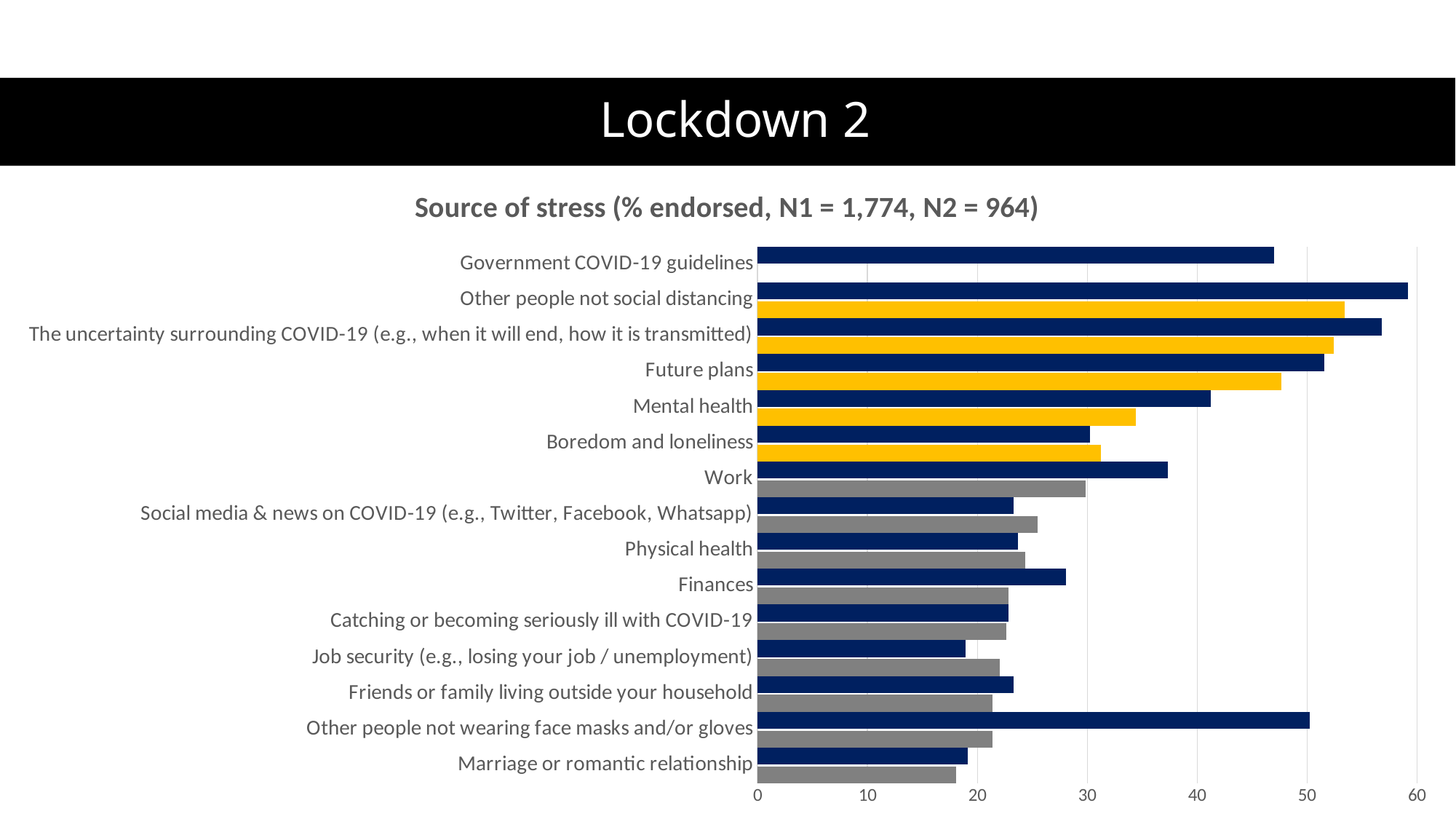
Is the value for Government COVID-19 guidelines greater or less than 40? greater What is the title of the chart? Source of stress (% endorsed, N1 = 1,774, N2 = 964) Is the dark blue bar for Work greater or less than 30? greater Is the grey bar for Marriage or romantic relationship greater or less than 20? less What kind of chart is shown on the slide? Bar chart Which is larger: the dark blue bar for Work or the dark blue bar for Finances? Work Which category has the longest bar on the chart? Other people not social distancing How many source-of-stress categories are listed on the chart? 15 Which is larger: the bar for Government COVID-19 guidelines or the dark blue bar for Marriage or romantic relationship? Government COVID-19 guidelines Which category has the shortest bar on the chart? Marriage or romantic relationship What is the highest value shown on the horizontal axis? 60